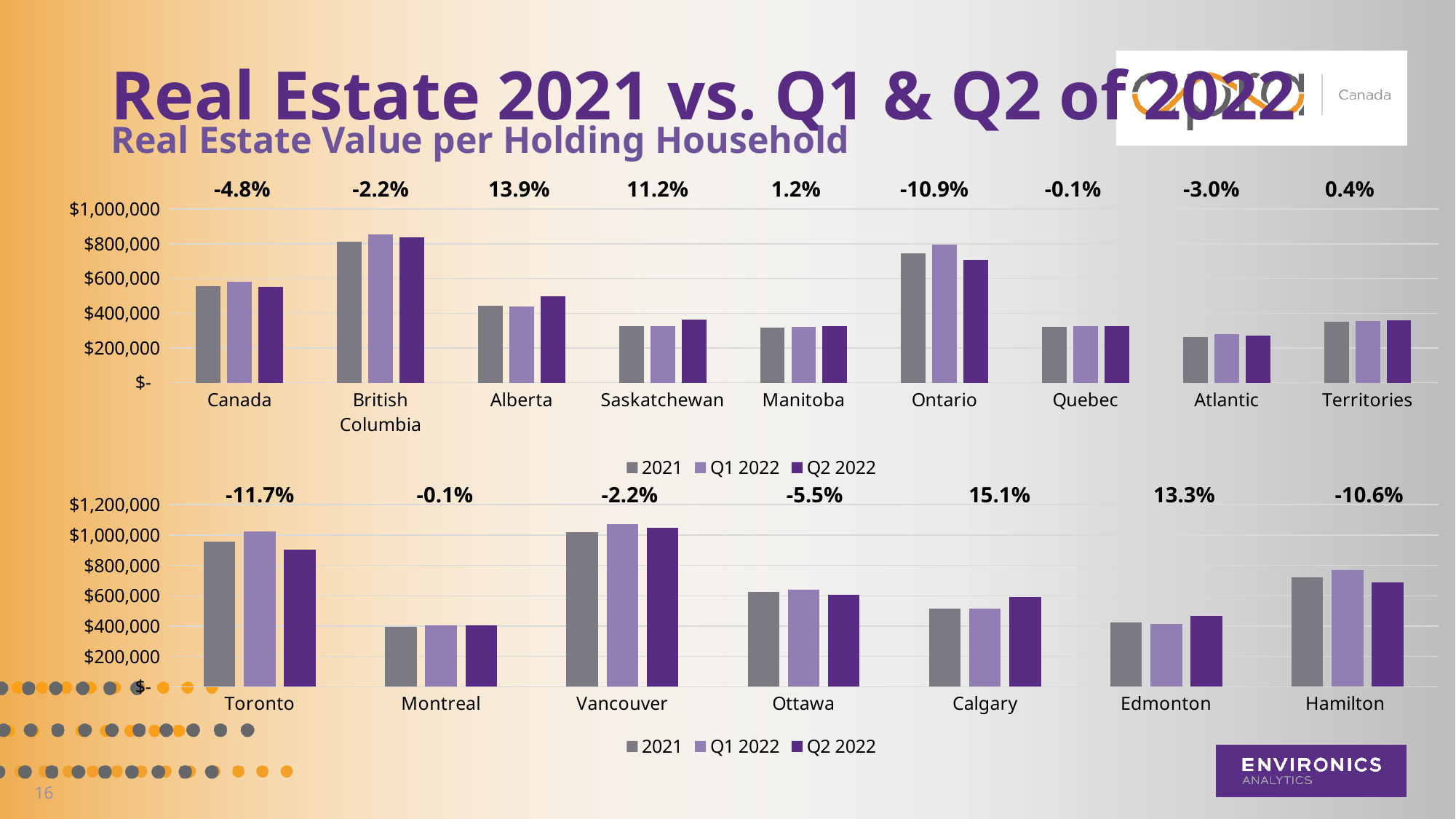
What kind of chart is the top chart? bar chart In the top chart, which category has the lowest printed percentage change? Ontario How many categories are shown on the x axis of the bottom chart? 7 In the top chart, what percentage change is printed above Alberta? 13.9% In the top chart, is the 2021 value for British Columbia greater or less than $600,000? greater In the bottom chart, what percentage change is printed above Calgary? 15.1% In the bottom chart, which city has the highest printed percentage change? Calgary In the top chart, which is larger, the 2021 value for Ontario or the 2021 value for Quebec? Ontario In the bottom chart, is the 2021 value for Montreal greater or less than $600,000? less In the bottom chart, which city has the tallest Q1 2022 bar? Vancouver How many series does the legend of the top chart list? 3 In the top chart, which category has the tallest 2021 bar? British Columbia